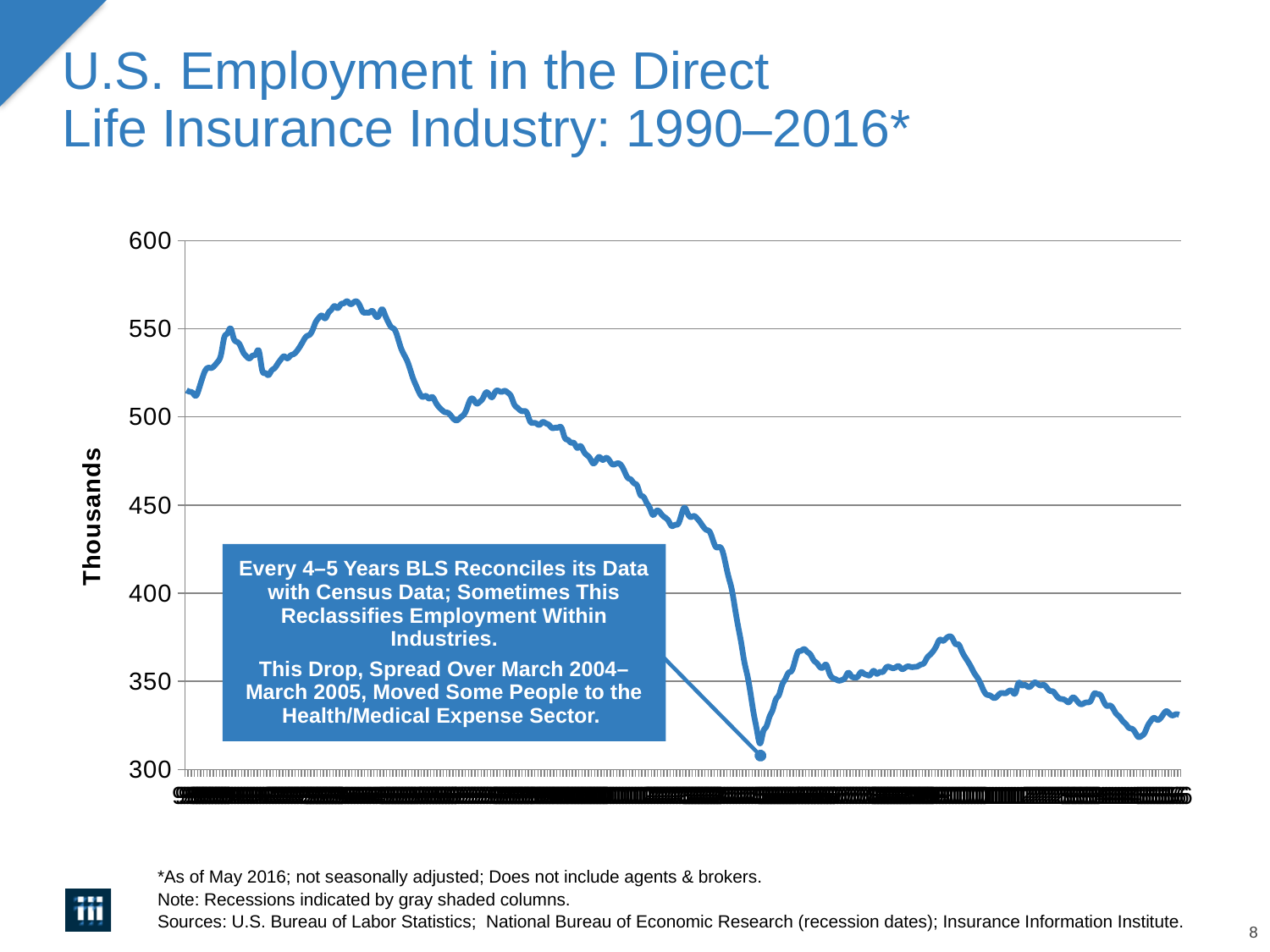
Is the highest value reached by the line greater or less than 550? greater What is the lowest value shown on the vertical axis? 300 What is the title of the chart? U.S. Employment in the Direct Life Insurance Industry: 1990–2016* Overall, do the values rise or fall from the start of the series in 1990 to the end in 2016? fall Is the lowest value reached by the line greater or less than 350? less Is the highest value reached by the line greater or less than 600? less What kind of chart is shown on the slide? line chart How many lines are plotted on the chart? 1 What is the label on the vertical axis of the chart? Thousands